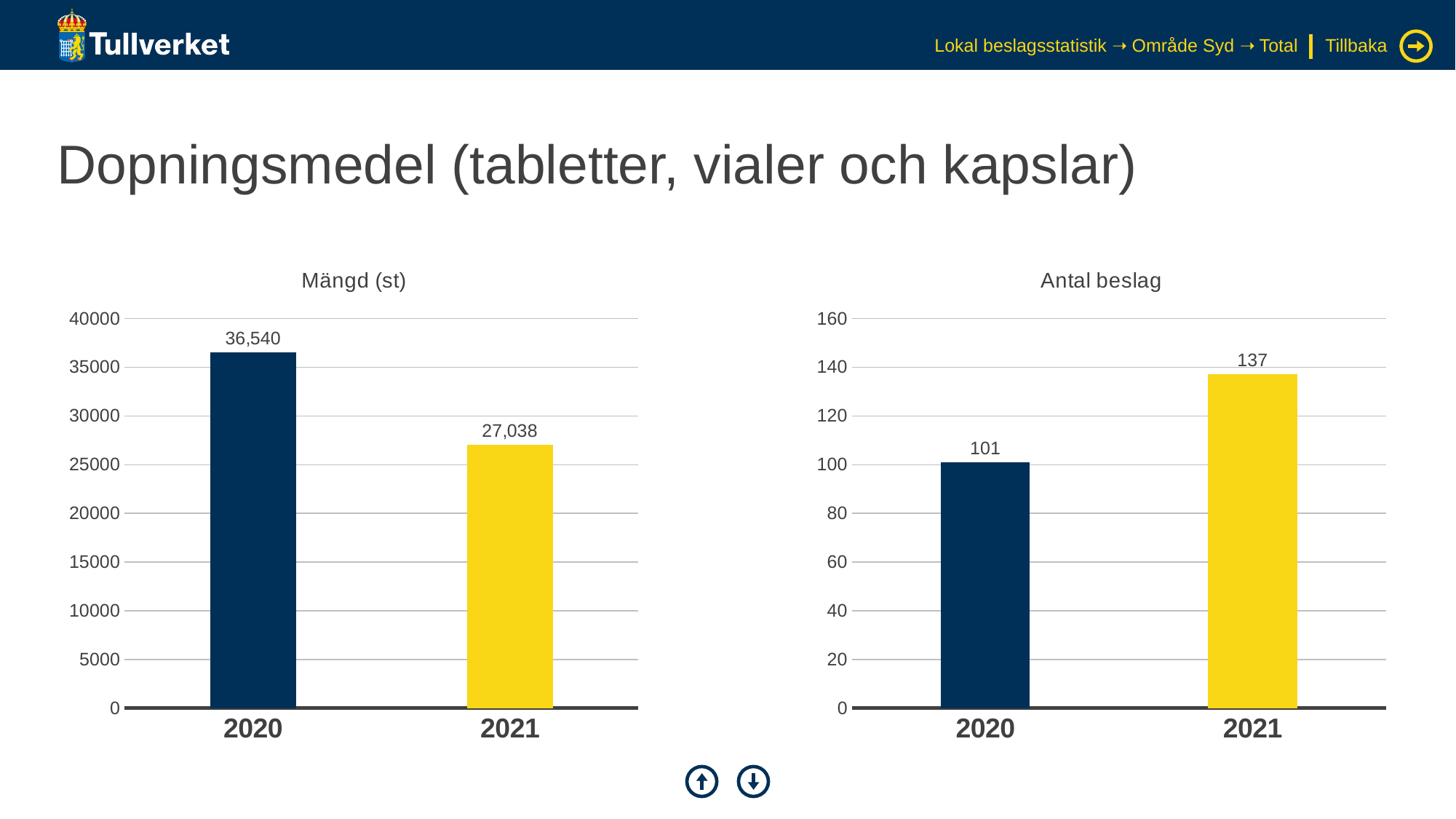
In the 'Antal beslag' chart, what is the value for 2020? 101 In the 'Antal beslag' chart, what is the value for 2021? 137 How many bars are shown in the 'Antal beslag' chart? 2 In the 'Mängd (st)' chart, what is the value for 2020? 36,540 In the 'Mängd (st)' chart, which year has the highest value? 2020 In the 'Mängd (st)' chart, do the values rise or fall from 2020 to 2021? Fall In the 'Mängd (st)' chart, what is the difference between the 2020 and 2021 values? 9,502 In the 'Antal beslag' chart, what is the difference between the 2021 and 2020 values? 36 In the 'Mängd (st)' chart, what is the value for 2021? 27,038 In the 'Antal beslag' chart, is the value for 2021 larger than the value for 2020? Yes In the 'Antal beslag' chart, which year has the lowest value? 2020 What type of chart is the 'Mängd (st)' chart? Bar chart